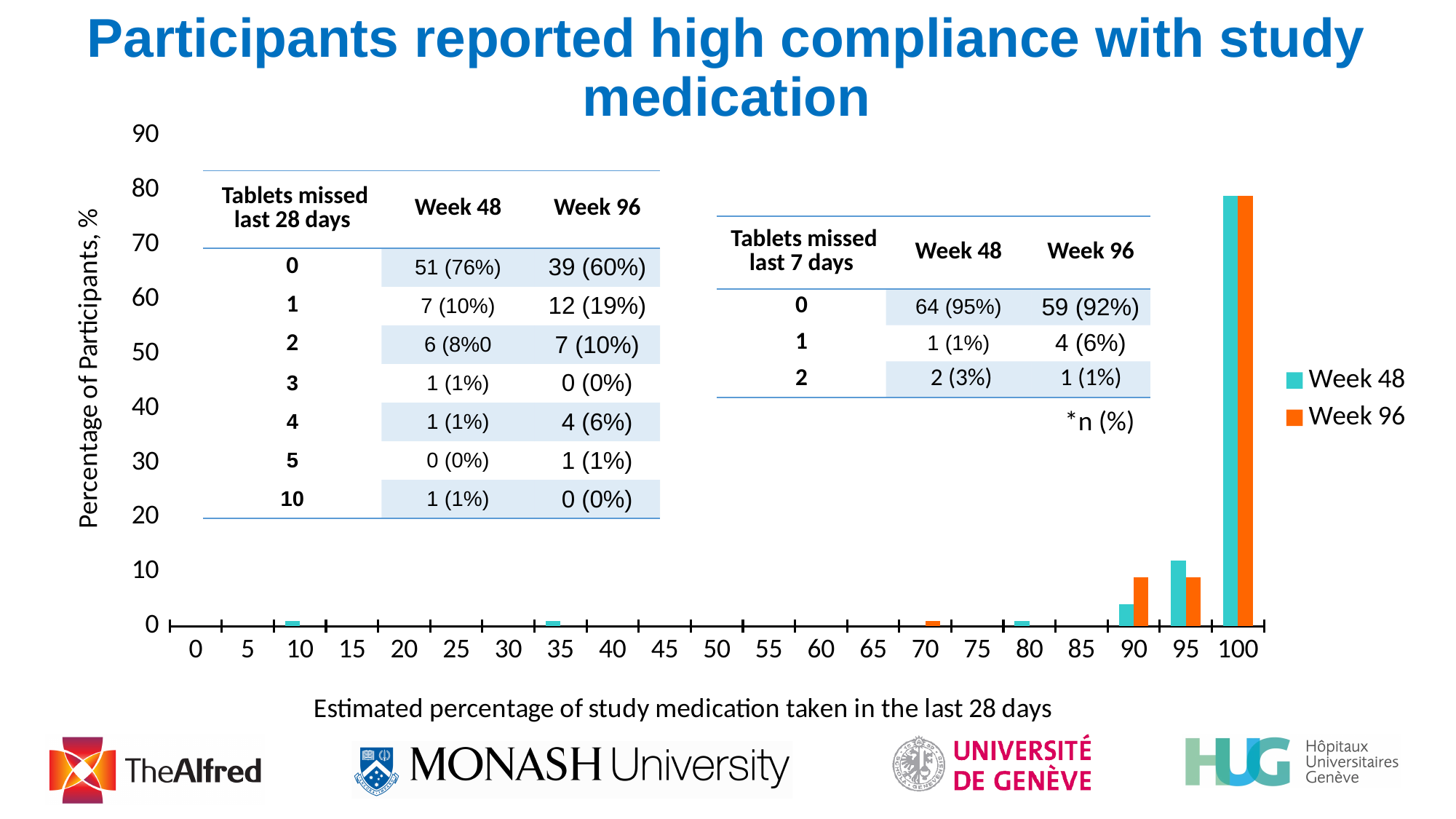
At x = 95, which series has the larger value, Week 48 or Week 96? Week 48 Is the Week 48 value at 100 greater or less than 70? greater At which x-axis value is the Week 96 bar highest? 100 At which x-axis value is the Week 48 bar highest? 100 Is the Week 48 value at 95 greater or less than 10? greater What kind of chart is shown on the slide? bar chart At x = 90, which series has the larger value, Week 48 or Week 96? Week 96 What is the x-axis title of the chart? Estimated percentage of study medication taken in the last 28 days How many series does the chart legend list? 2 Is the Week 96 value at 90 greater or less than 5? greater What are the two series named in the chart legend? Week 48 and Week 96